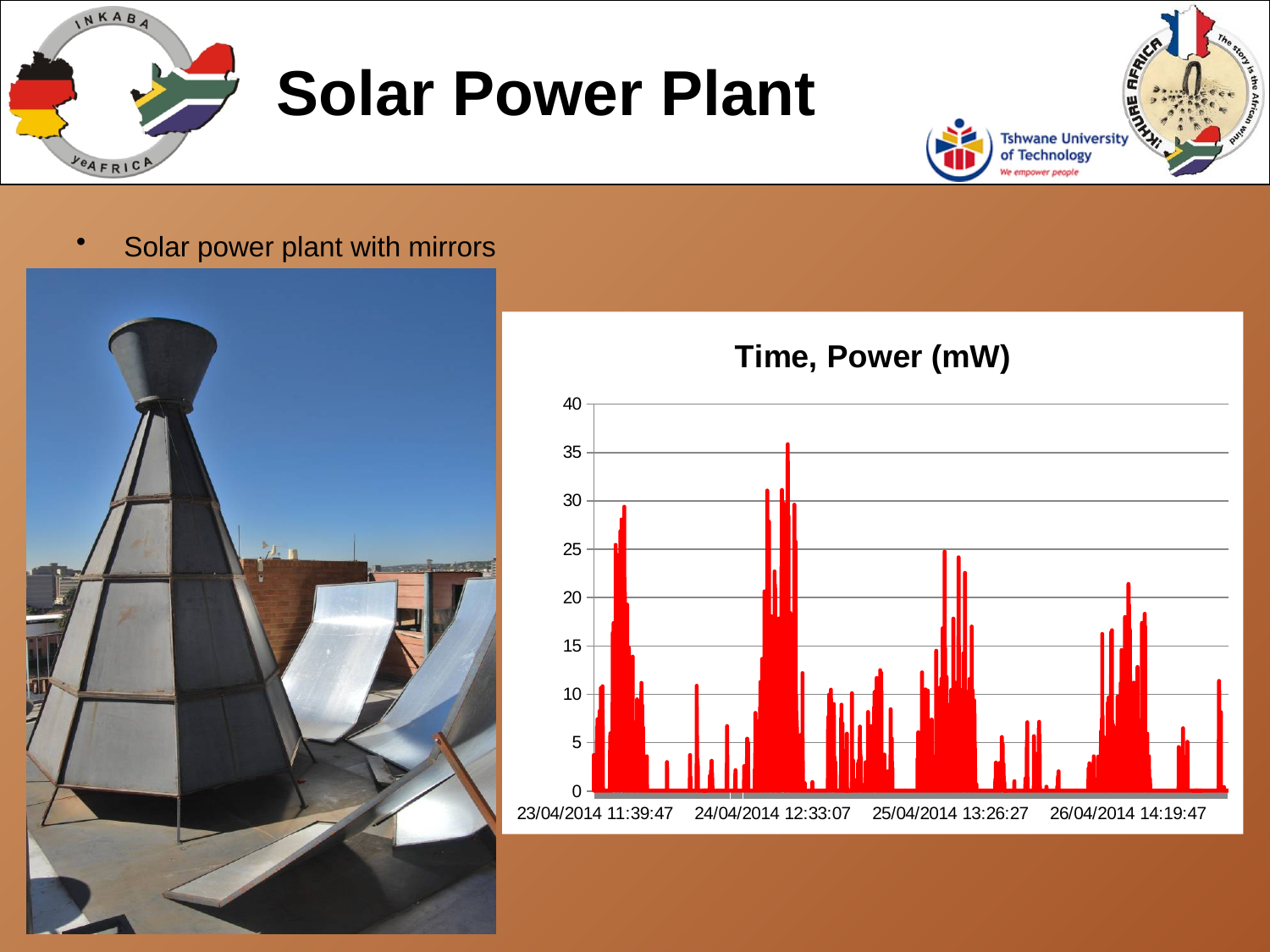
What is the title of the chart? Time, Power (mW) What is the first date-time label on the x axis of the chart? 23/04/2014 11:39:47 Is the tallest peak near the 23/04/2014 11:39:47 label greater or less than 25? greater Which is taller: the highest peak near 24/04/2014 12:33:07 or the highest peak near 26/04/2014 14:19:47? 24/04/2014 12:33:07 How many date-time labels are shown along the x axis of the chart? 4 Is the tallest peak near the 26/04/2014 14:19:47 label greater or less than 25? less What is the highest value shown on the chart's vertical axis? 40 Is the highest peak on the chart greater or less than 30? greater Near which x-axis label does the tallest peak of the chart occur? 24/04/2014 12:33:07 What is the last date-time label on the x axis of the chart? 26/04/2014 14:19:47 What colour is the plotted data on the chart? Red